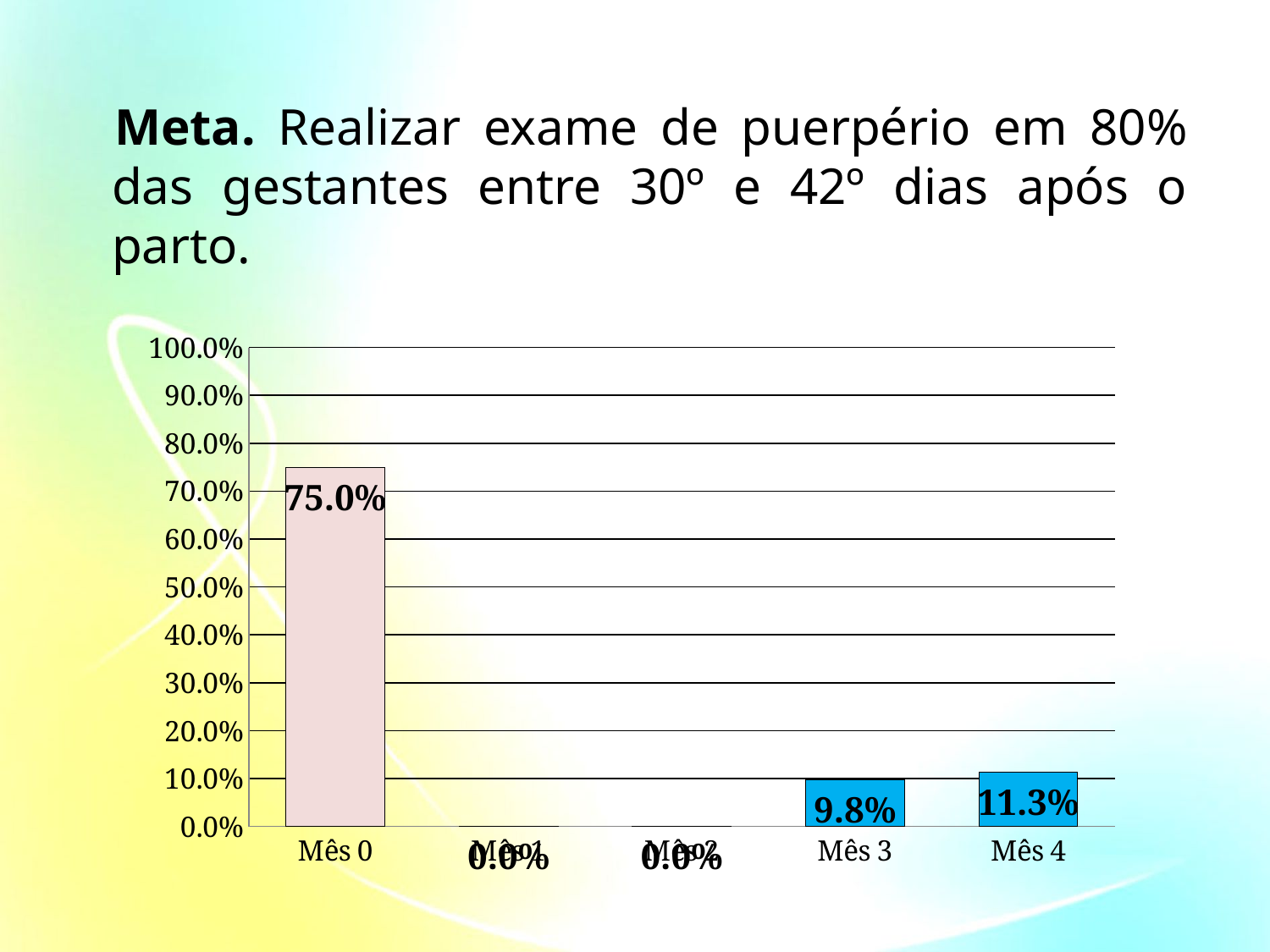
What is the value for Mês 4? 11.3% Which month has the highest value? Mês 0 What is the value for Mês 3? 9.8% How many months have a value of 0.0%? 2 What is the value for Mês 1? 0.0% Which is larger, the value for Mês 3 or the value for Mês 4? Mês 4 How many months are shown on the x axis? 5 What is the difference between the values for Mês 0 and Mês 4? 63.7% What is the value for Mês 0? 75.0% What is the difference between the values for Mês 4 and Mês 3? 1.5% Is the value for Mês 0 greater or less than 80.0%? less What kind of chart is shown on the slide? bar chart